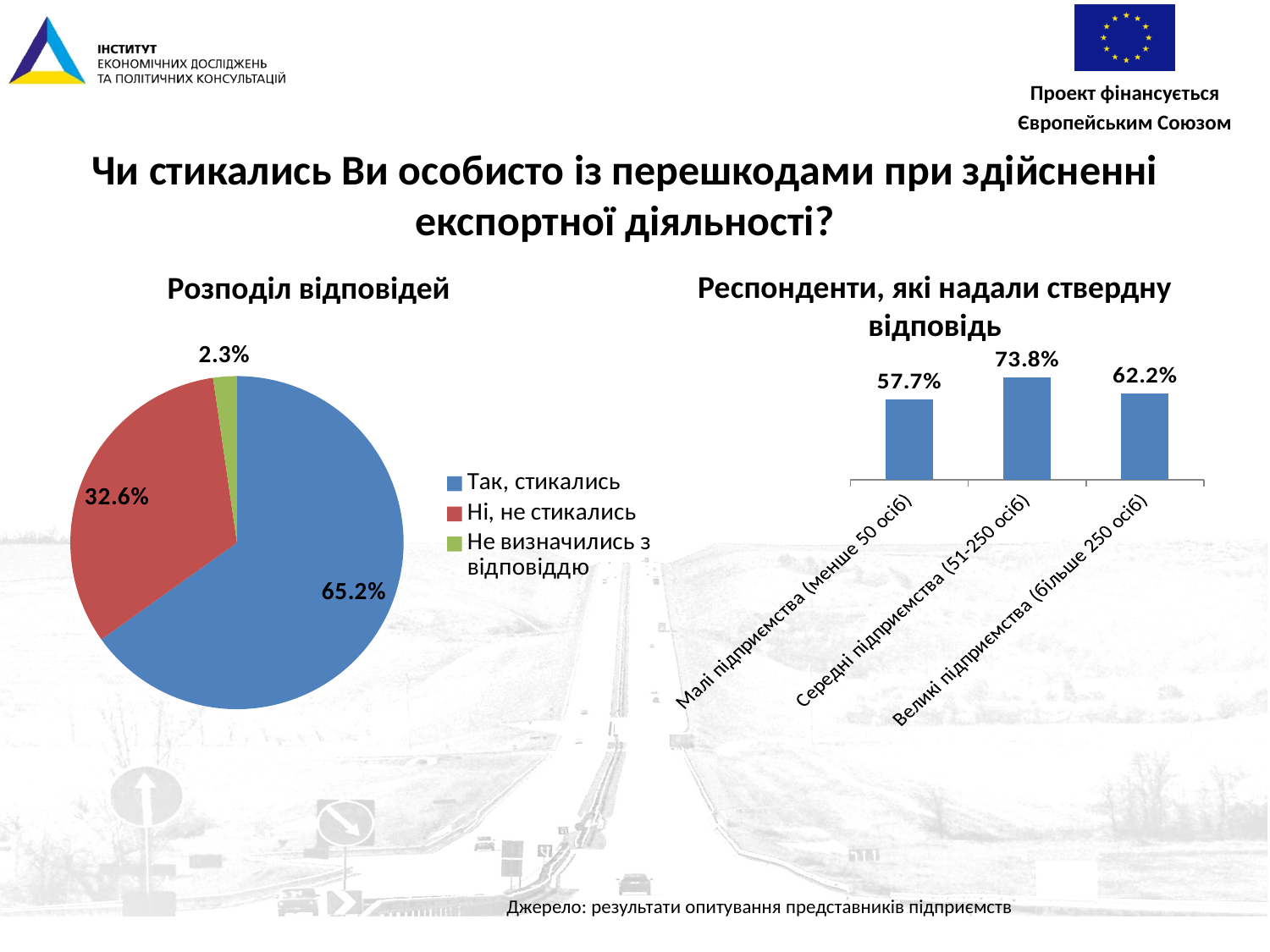
In the pie chart "Розподіл відповідей", what share of respondents answered "Ні, не стикались"? 32.6% In the bar chart "Респонденти, які надали ствердну відповідь", which category has the highest value? Середні підприємства (51-250 осіб) In the pie chart "Розподіл відповідей", what is the difference between the shares for "Так, стикались" and "Ні, не стикались"? 32.6% In the pie chart "Розподіл відповідей", what share of respondents answered "Так, стикались"? 65.2% In the bar chart "Респонденти, які надали ствердну відповідь", what is the difference between the values for "Середні підприємства (51-250 осіб)" and "Великі підприємства (більше 250 осіб)"? 11.6% In the pie chart "Розподіл відповідей", how many slices are there? 3 In the pie chart "Розподіл відповідей", what share of respondents answered "Не визначились з відповіддю"? 2.3% In the bar chart "Респонденти, які надали ствердну відповідь", what is the value for "Середні підприємства (51-250 осіб)"? 73.8% In the bar chart "Респонденти, які надали ствердну відповідь", which category has the lowest value? Малі підприємства (менше 50 осіб) In the pie chart "Розподіл відповідей", which answer has the smallest slice? Не визначились з відповіддю In the bar chart "Респонденти, які надали ствердну відповідь", what is the value for "Малі підприємства (менше 50 осіб)"? 57.7% What type of chart is the chart on the right of the slide, titled "Респонденти, які надали ствердну відповідь"? Bar chart